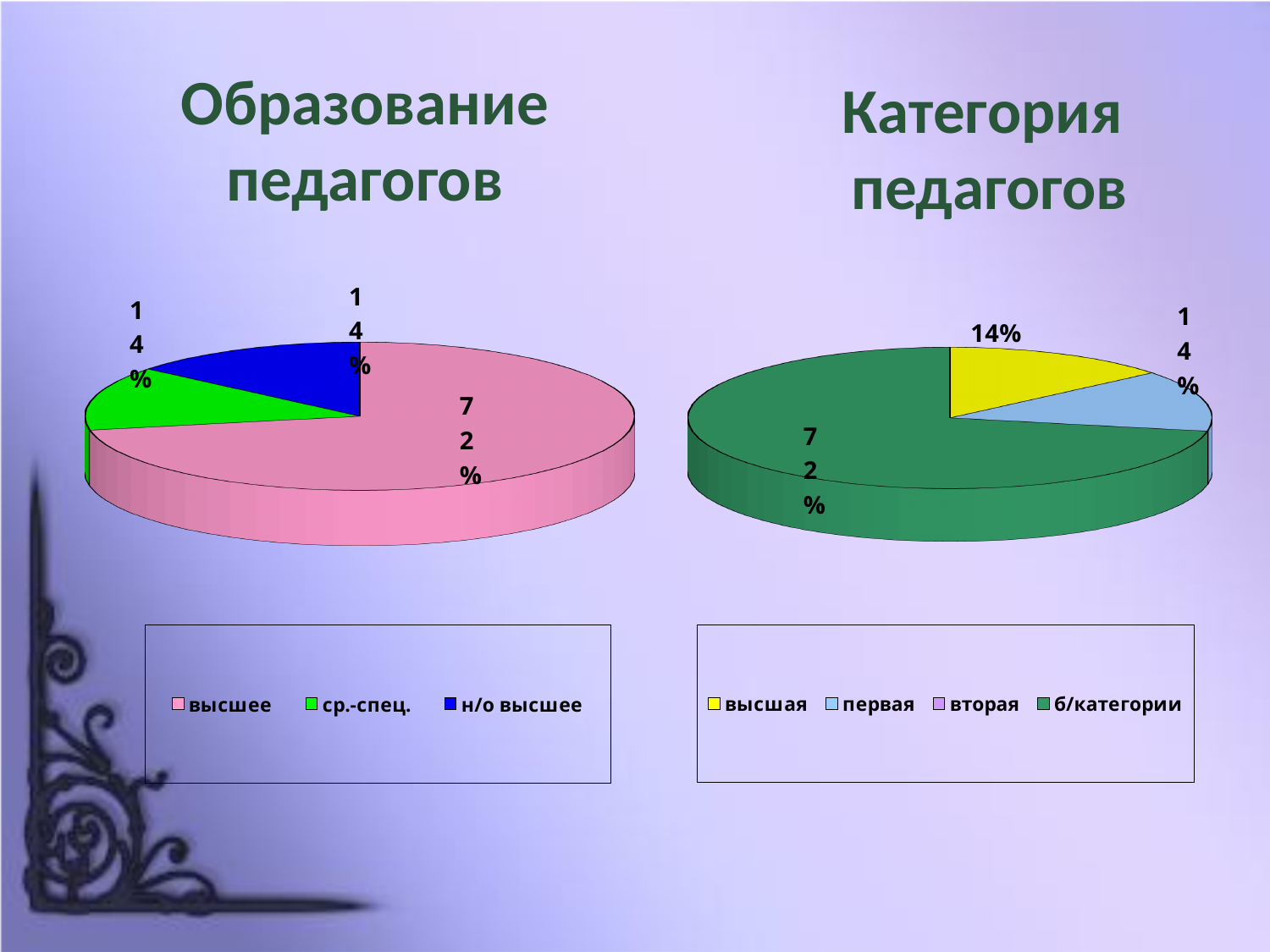
In the "Категория педагогов" chart, what percentage is shown for б/категории? 72% In the "Категория педагогов" chart, how many entries does the legend list? 4 In the "Категория педагогов" chart, which is larger: the share for б/категории or the share for первая? б/категории In the "Категория педагогов" chart, what percentage is shown for высшая? 14% In the "Образование педагогов" chart, what percentage is shown for высшее? 72% In the "Категория педагогов" chart, which category has the largest share? б/категории In the "Образование педагогов" chart, how many categories does the legend list? 3 In the "Категория педагогов" chart, what colour is the б/категории slice? green In the "Образование педагогов" chart, what is the difference between the shares of высшее and н/о высшее? 58% In the "Образование педагогов" chart, which category has the largest share? высшее What type of chart is the "Образование педагогов" chart? pie chart In the "Образование педагогов" chart, what percentage is shown for ср.-спец.? 14%